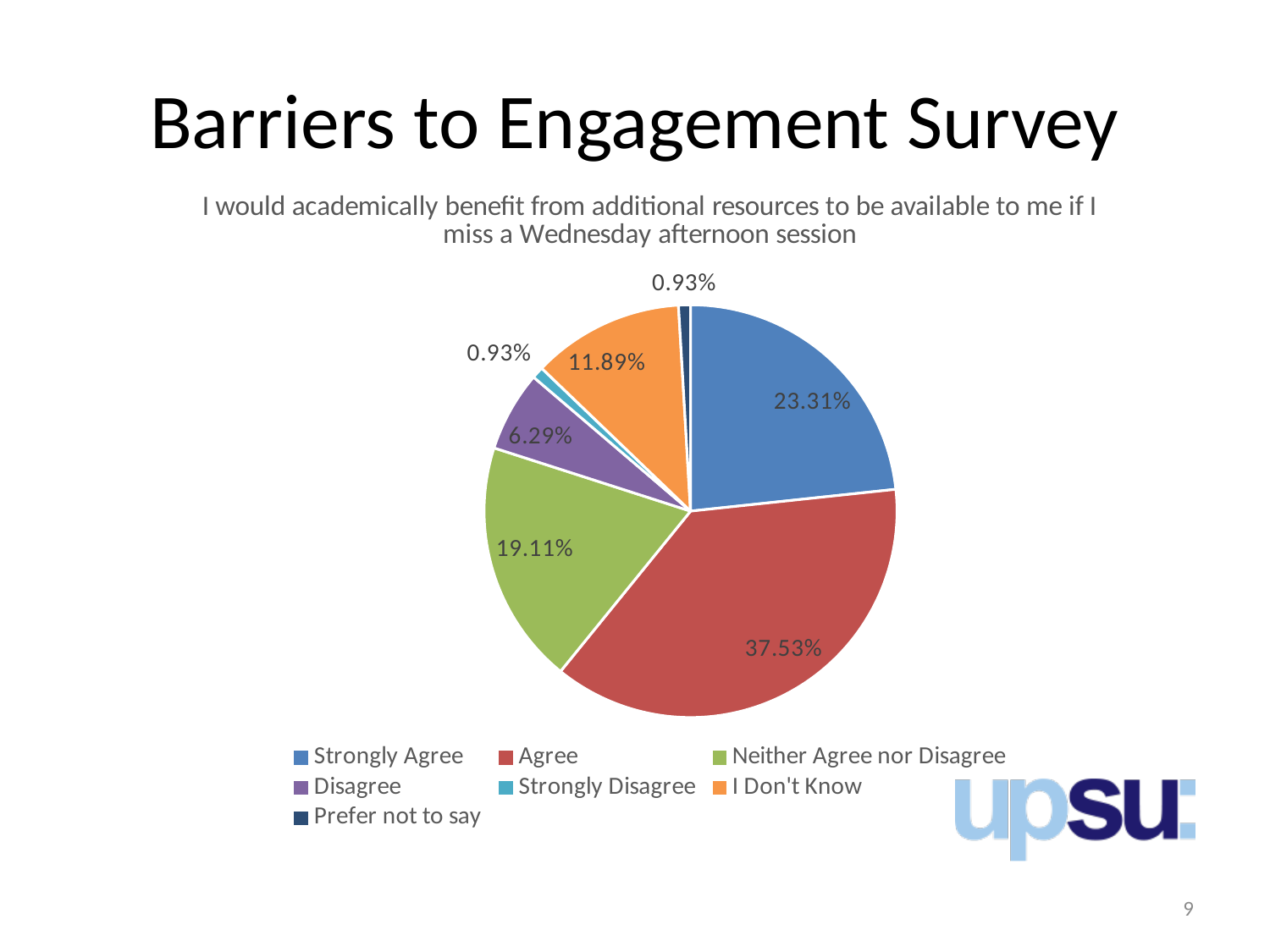
What kind of chart is shown on the slide? pie chart What percentage of respondents answered "Agree"? 37.53% What is the combined share of "Strongly Agree" and "Agree"? 60.84% Which is larger, the share for "Strongly Agree" or the share for "Neither Agree nor Disagree"? Strongly Agree How many response categories does the legend list? 7 What percentage of respondents answered "I Don't Know"? 11.89% What percentage of respondents answered "Neither Agree nor Disagree"? 19.11% What is the difference in percentage points between "Agree" and "Strongly Agree"? 14.22 Which response has the largest share of the pie? Agree What percentage of respondents answered "Disagree"? 6.29% What colour is the "I Don't Know" slice? orange What percentage of respondents answered "Strongly Agree"? 23.31%